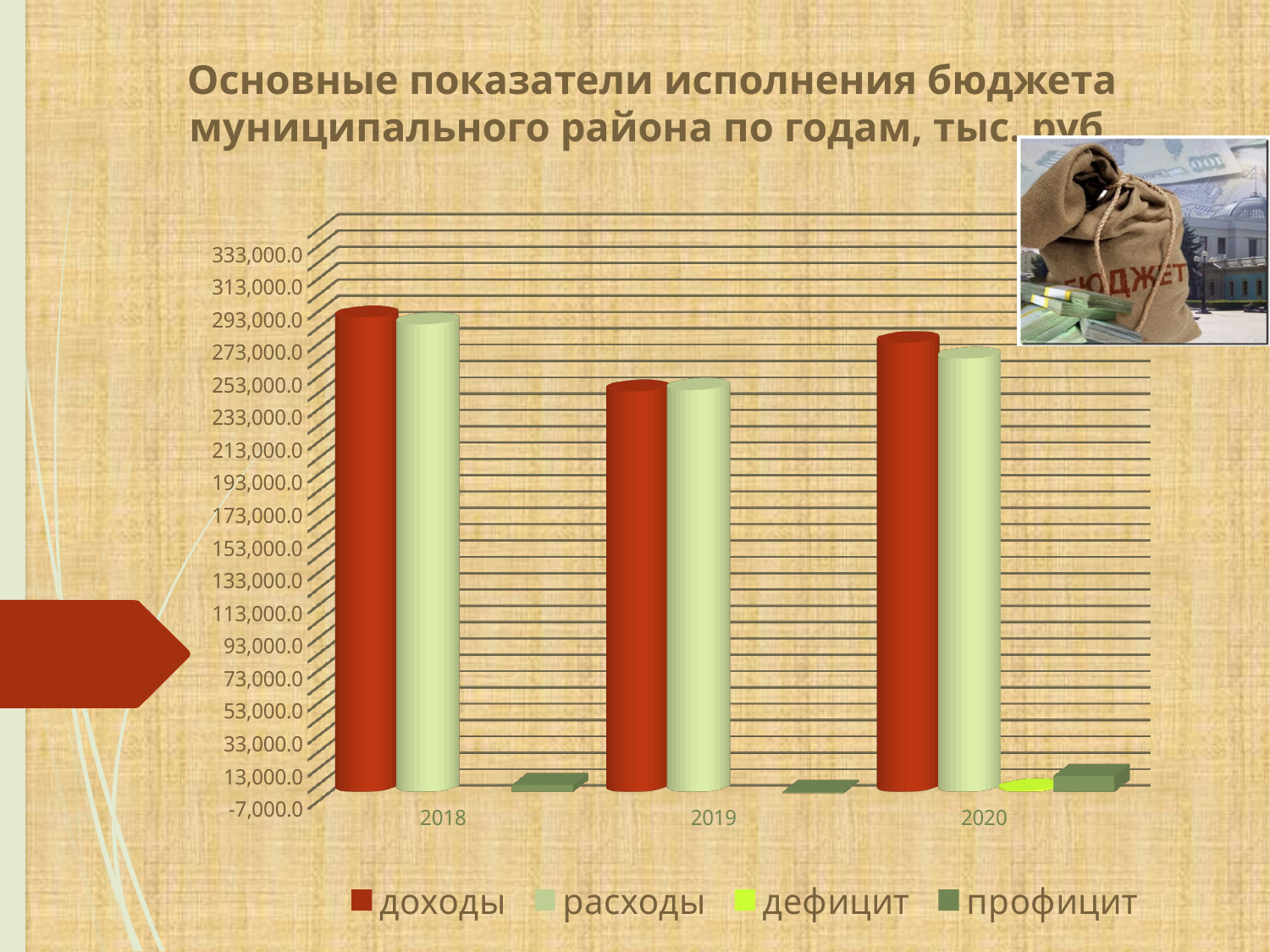
Is the value for доходы in 2018 greater or less than 253,000.0? greater Which is larger, доходы in 2018 or доходы in 2019? доходы in 2018 What kind of chart is shown on the slide? bar chart Is the value for расходы in 2019 greater or less than 273,000.0? less Is the value for доходы in 2019 greater or less than 213,000.0? greater Which is larger, расходы in 2020 or расходы in 2019? расходы in 2020 In which year is the value for доходы the lowest? 2019 Which colour represents the доходы series in the chart? red How many series does the chart legend list? 4 How many years are shown on the x axis of the chart? 3 Which series are listed in the chart legend? доходы, расходы, дефицит, профицит In which year is the value for доходы the highest? 2018